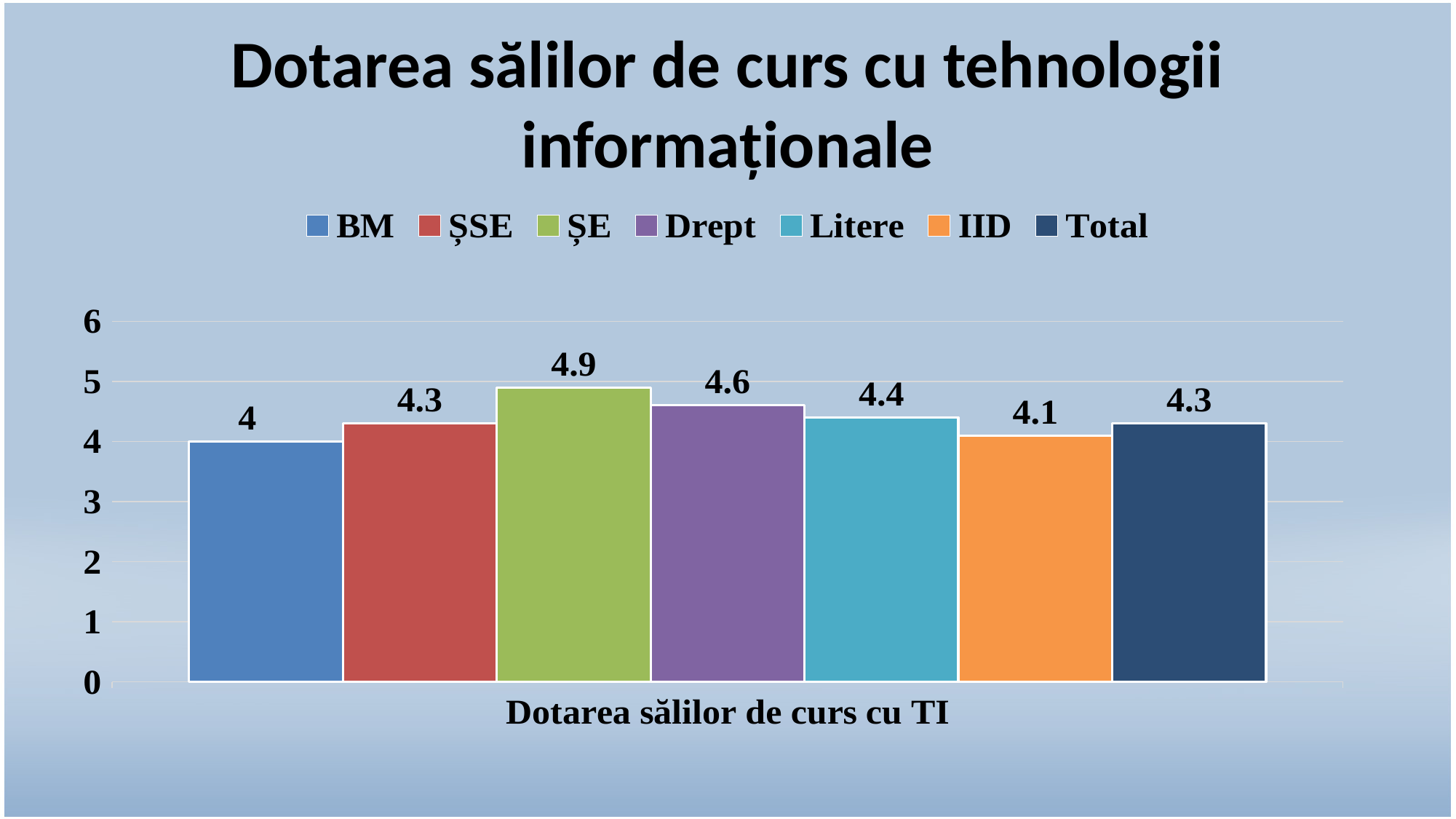
What is the difference between the values for Drept and IID? 0.5 How many series does the legend list? 7 What kind of chart is shown on the slide? bar chart What is the value for ȘE? 4.9 What is the value for Total? 4.3 What is the value for Litere? 4.4 Which series has the lowest value? BM What is the value for BM? 4 What is the label shown below the x axis of the chart? Dotarea sălilor de curs cu TI What is the difference between the values for ȘE and BM? 0.9 Which series has the highest value? ȘE Which is larger, the value for Drept or the value for Litere? Drept